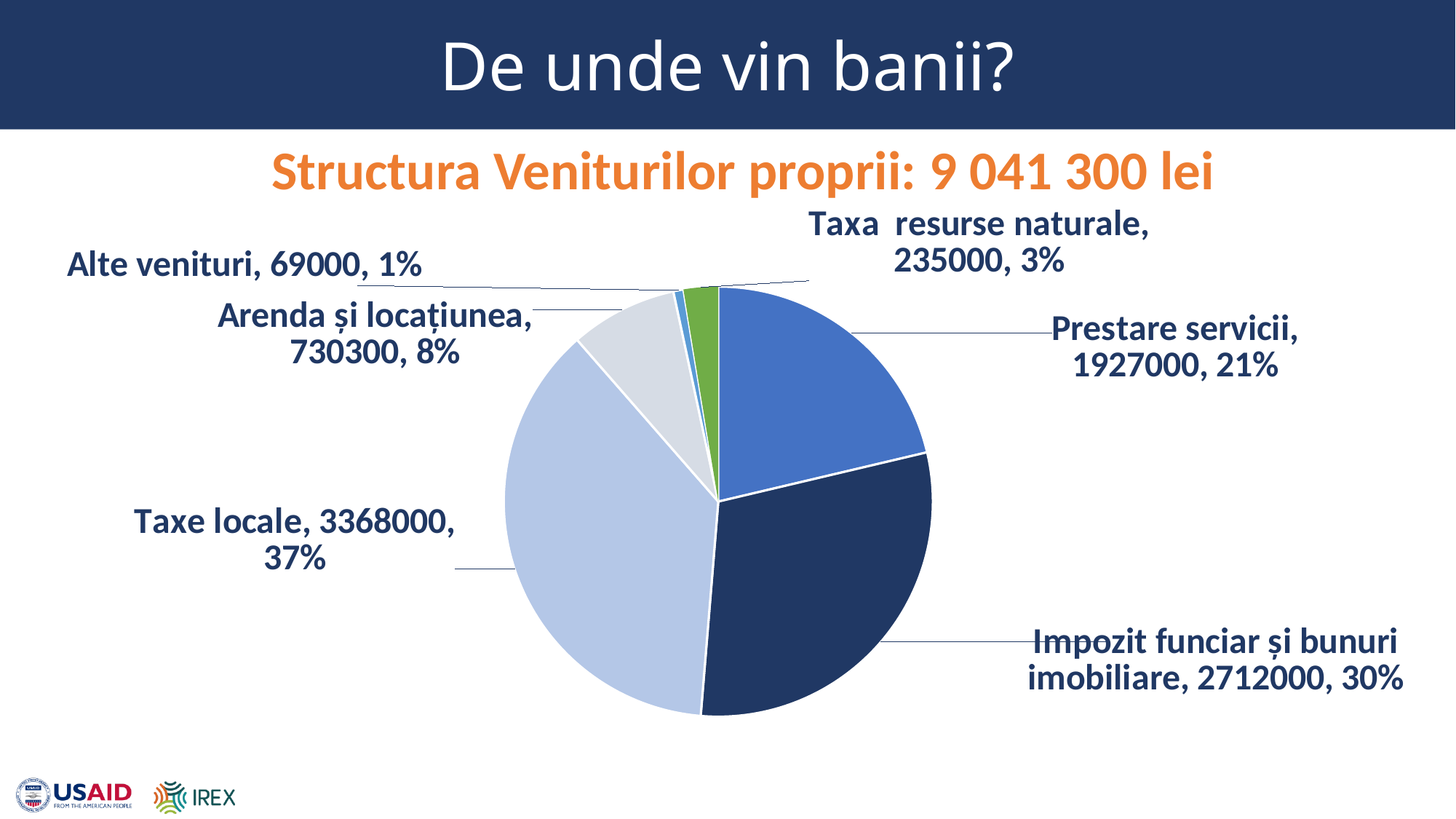
What is the value for Taxe locale? 3368000 What is the difference between the values for Taxe locale and Impozit funciar și bunuri imobiliare? 656000 What share of the pie does Impozit funciar și bunuri imobiliare represent? 30% What is the value for Arenda și locațiunea? 730300 What kind of chart is shown on the slide? pie chart How many categories does the pie chart show? 6 What is the value for Impozit funciar și bunuri imobiliare? 2712000 Which category has the smallest slice of the pie? Alte venituri What share of the pie does Taxa resurse naturale represent? 3% What is the value for Prestare servicii? 1927000 Which category has the largest slice of the pie? Taxe locale Which is larger, the value for Prestare servicii or the value for Arenda și locațiunea? Prestare servicii